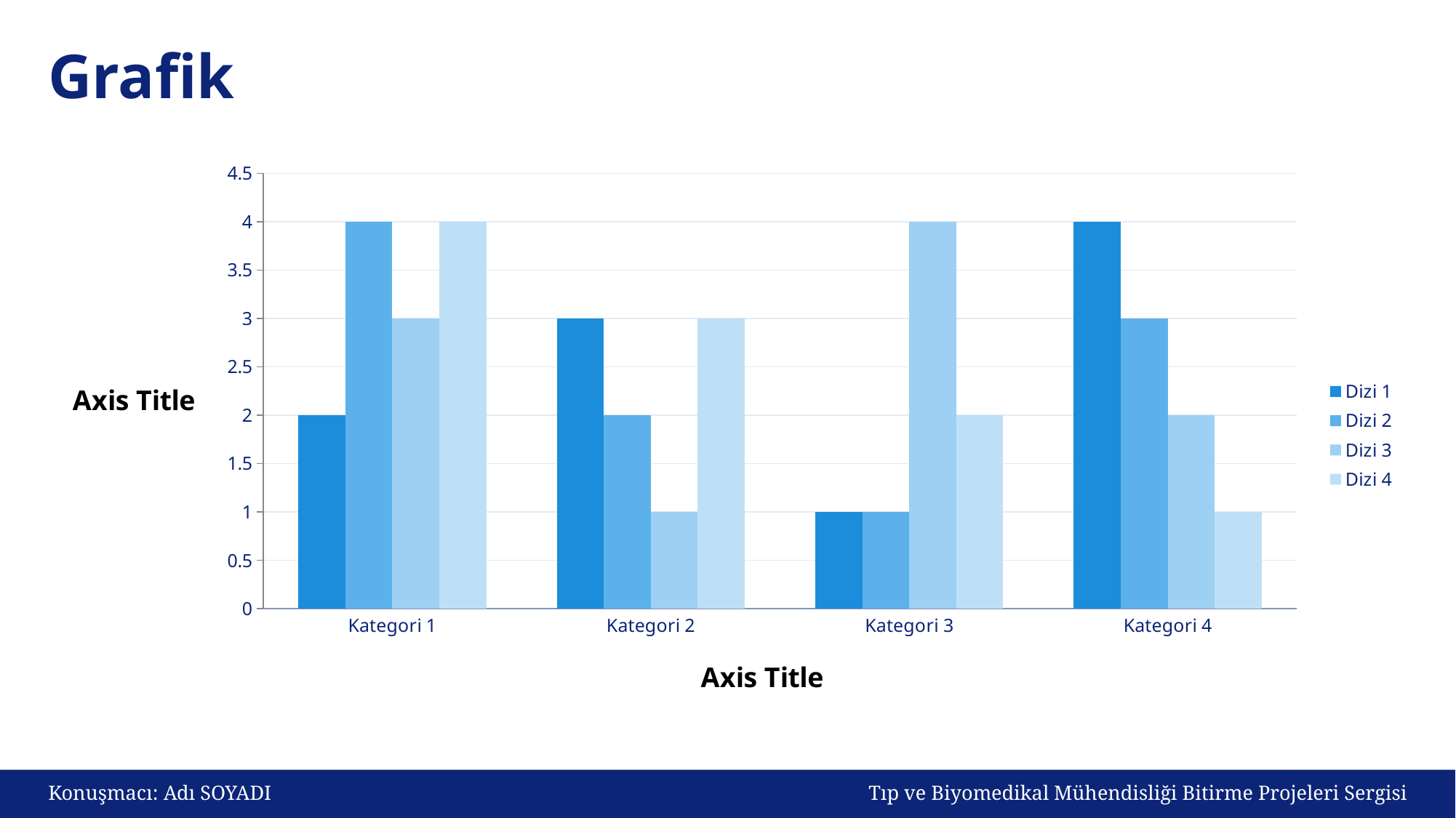
What is the value of Dizi 4 for Kategori 3? 2 Which category has the highest value for Dizi 3? Kategori 3 What is the title of the slide? Grafik What is the value of Dizi 3 for Kategori 2? 1 What is the difference between Dizi 2 and Dizi 1 for Kategori 1? 2 For Kategori 2, which is larger: Dizi 1 or Dizi 2? Dizi 1 What kind of chart is shown on the slide? bar chart Which category has the lowest value for Dizi 4? Kategori 4 Is the value of Dizi 1 for Kategori 3 greater or less than 2? less How many series does the legend list? 4 What is the value of Dizi 1 for Kategori 4? 4 How many categories are shown on the x axis? 4